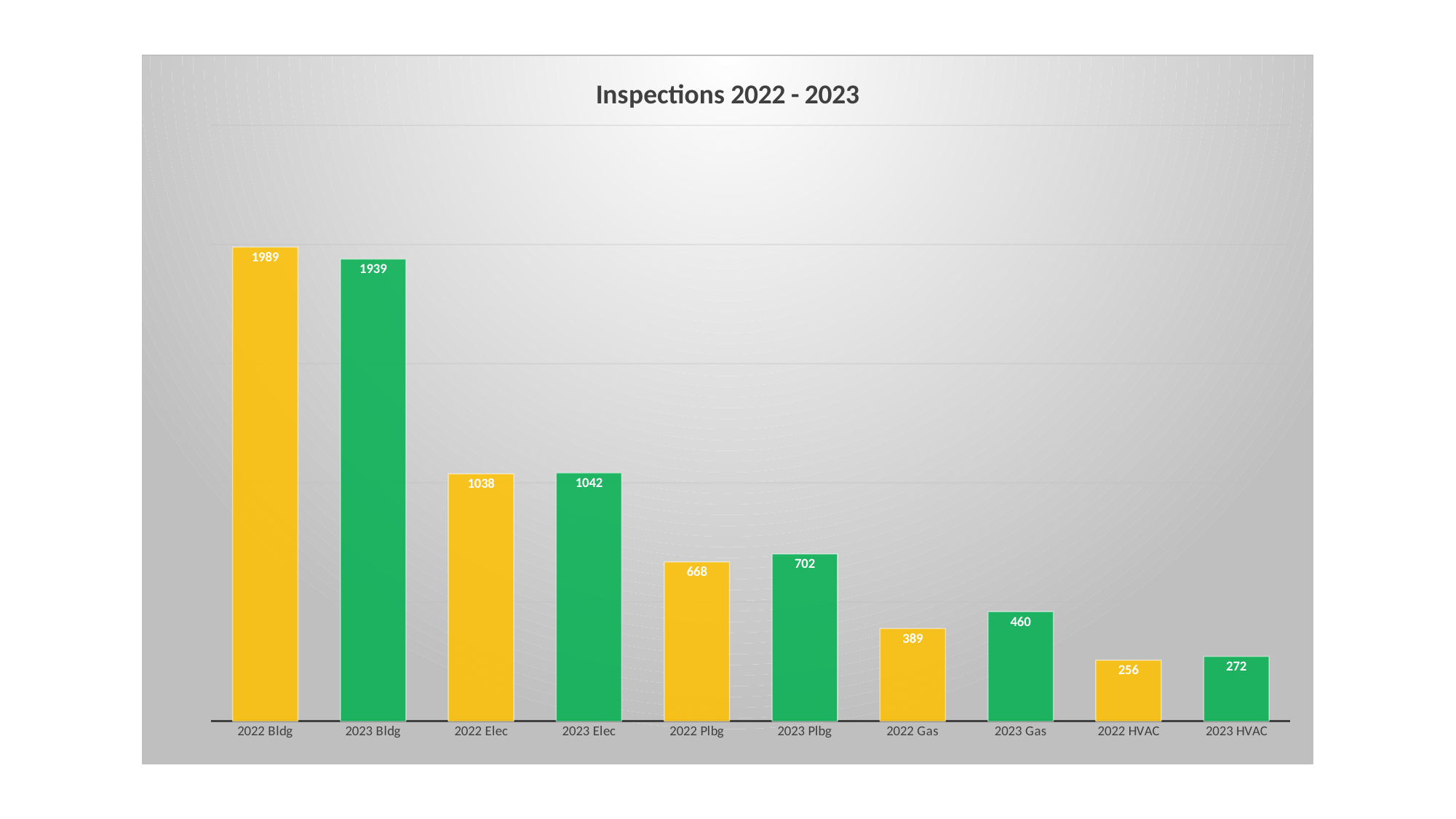
How many bars are shown in the chart? 10 What is the value for 2022 HVAC? 256 Which is larger, 2022 Plbg or 2023 Plbg? 2023 Plbg What kind of chart is this? Bar chart What is the difference between 2022 Bldg and 2023 Bldg? 50 Which is larger, 2022 Elec or 2023 Elec? 2023 Elec What is the difference between 2023 Gas and 2022 Gas? 71 What is the value for 2022 Bldg? 1989 What is the title of the chart? Inspections 2022 - 2023 Which category has the highest value? 2022 Bldg What is the value for 2023 Plbg? 702 Which category has the lowest value? 2022 HVAC